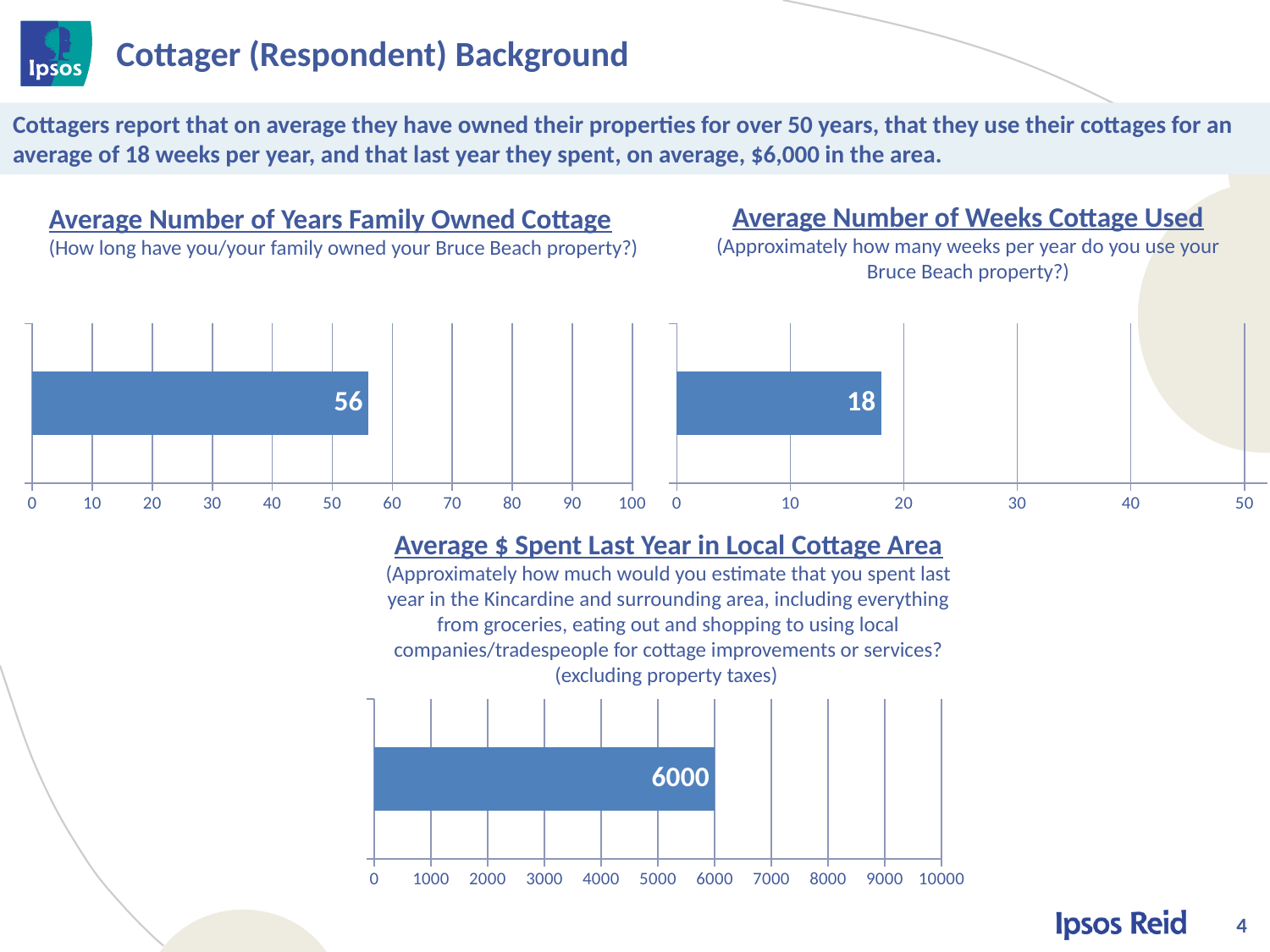
How many bars are plotted in the 'Average Number of Weeks Cottage Used' chart? 1 In the 'Average $ Spent Last Year in Local Cottage Area' chart, is the value greater or less than 5000? greater What is the maximum value shown on the x axis of the 'Average Number of Weeks Cottage Used' chart? 50 In the 'Average Number of Years Family Owned Cottage' chart, is the value greater or less than 50? greater What is the maximum value shown on the x axis of the 'Average Number of Years Family Owned Cottage' chart? 100 In the 'Average $ Spent Last Year in Local Cottage Area' chart, what value is shown on the bar? 6000 In the 'Average Number of Years Family Owned Cottage' chart, what value is shown on the bar? 56 In the 'Average Number of Weeks Cottage Used' chart, what value is shown on the bar? 18 What kind of chart is the 'Average $ Spent Last Year in Local Cottage Area' chart? bar chart How many charts are shown on the slide? 3 In the 'Average Number of Weeks Cottage Used' chart, is the value greater or less than 20? less What kind of chart is the 'Average Number of Years Family Owned Cottage' chart? bar chart